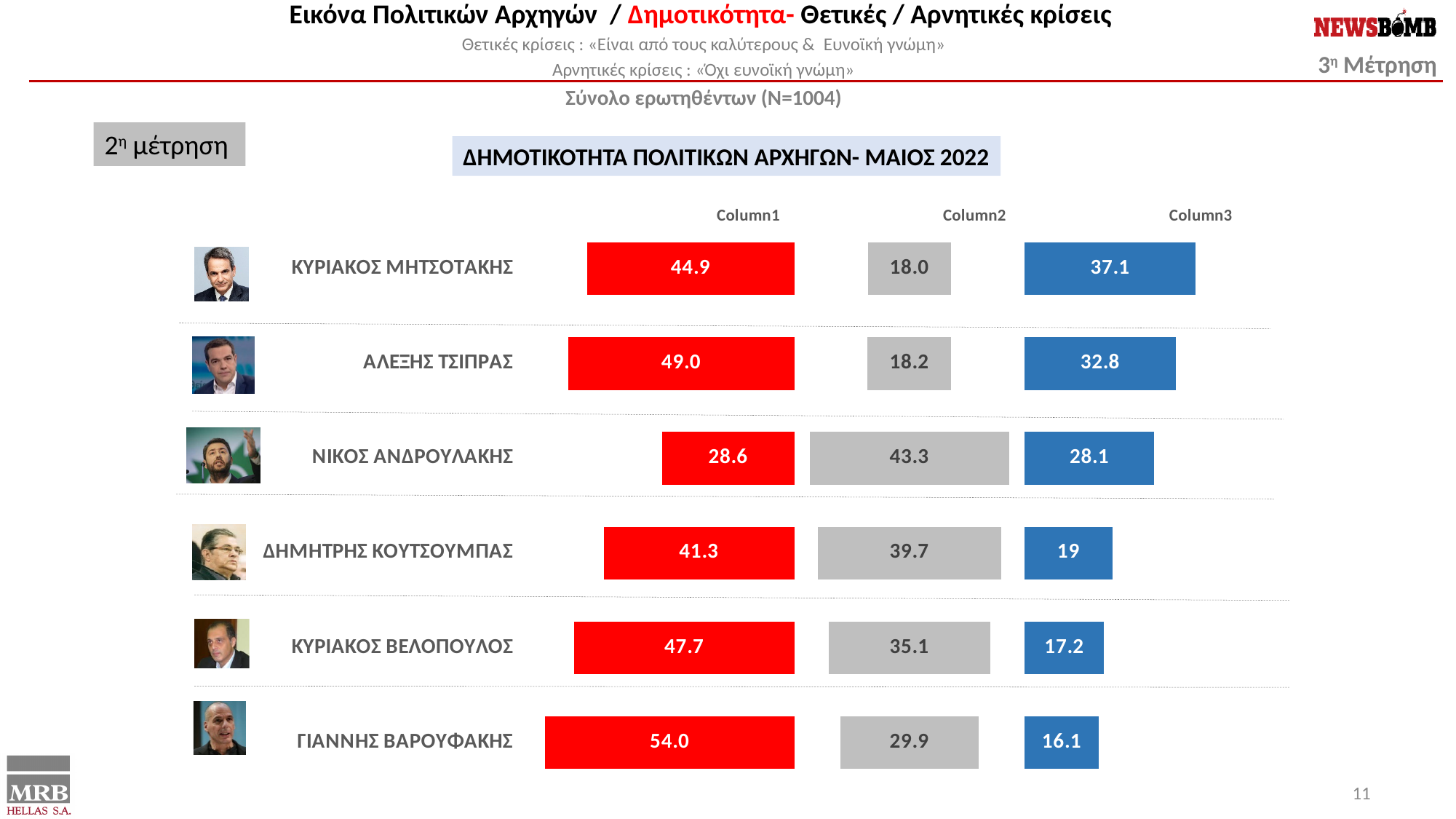
What is the Column1 value for ΓΙΑΝΝΗΣ ΒΑΡΟΥΦΑΚΗΣ? 54.0 What kind of chart is shown on the slide? Bar chart What is the difference between the Column2 and Column3 values for ΚΥΡΙΑΚΟΣ ΒΕΛΟΠΟΥΛΟΣ? 17.9 Which politician has the lowest Column1 value? ΝΙΚΟΣ ΑΝΔΡΟΥΛΑΚΗΣ Which politician has the highest Column1 value? ΓΙΑΝΝΗΣ ΒΑΡΟΥΦΑΚΗΣ Who has the larger Column3 value, ΚΥΡΙΑΚΟΣ ΜΗΤΣΟΤΑΚΗΣ or ΑΛΕΞΗΣ ΤΣΙΠΡΑΣ? ΚΥΡΙΑΚΟΣ ΜΗΤΣΟΤΑΚΗΣ Which politician has the lowest Column3 value? ΓΙΑΝΝΗΣ ΒΑΡΟΥΦΑΚΗΣ What is the difference between the Column1 values of ΑΛΕΞΗΣ ΤΣΙΠΡΑΣ and ΚΥΡΙΑΚΟΣ ΜΗΤΣΟΤΑΚΗΣ? 4.1 What is the Column2 value for ΝΙΚΟΣ ΑΝΔΡΟΥΛΑΚΗΣ? 43.3 How many series (columns) does the chart show? 3 What is the Column3 value for ΚΥΡΙΑΚΟΣ ΒΕΛΟΠΟΥΛΟΣ? 17.2 How many politicians are shown in the chart? 6